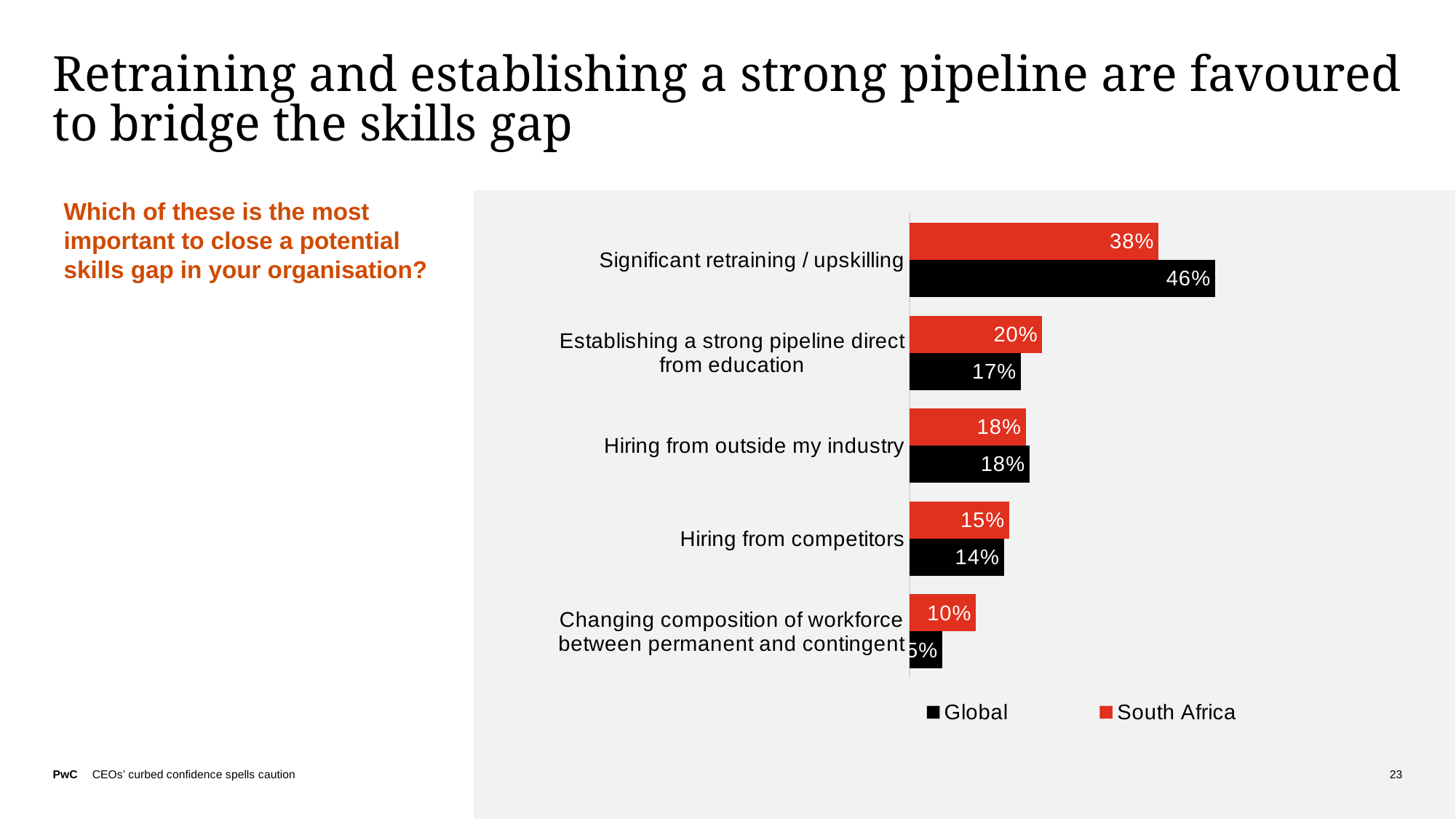
How many series does the legend list? 2 Which category has the highest South Africa value? Significant retraining / upskilling Which category has the lowest Global value? Changing composition of workforce between permanent and contingent What is the Global value for Significant retraining / upskilling? 46% What kind of chart is shown on the slide? Bar chart What is the South Africa value for Establishing a strong pipeline direct from education? 20% What is the difference between the Global and South Africa values for Significant retraining / upskilling? 8% What is the Global value for Changing composition of workforce between permanent and contingent? 5% How many categories are shown in the chart? 5 What is the difference between the South Africa and Global values for Changing composition of workforce between permanent and contingent? 5% Which colour represents the South Africa series in the chart? Red Which is larger for Hiring from competitors, the Global value or the South Africa value? South Africa